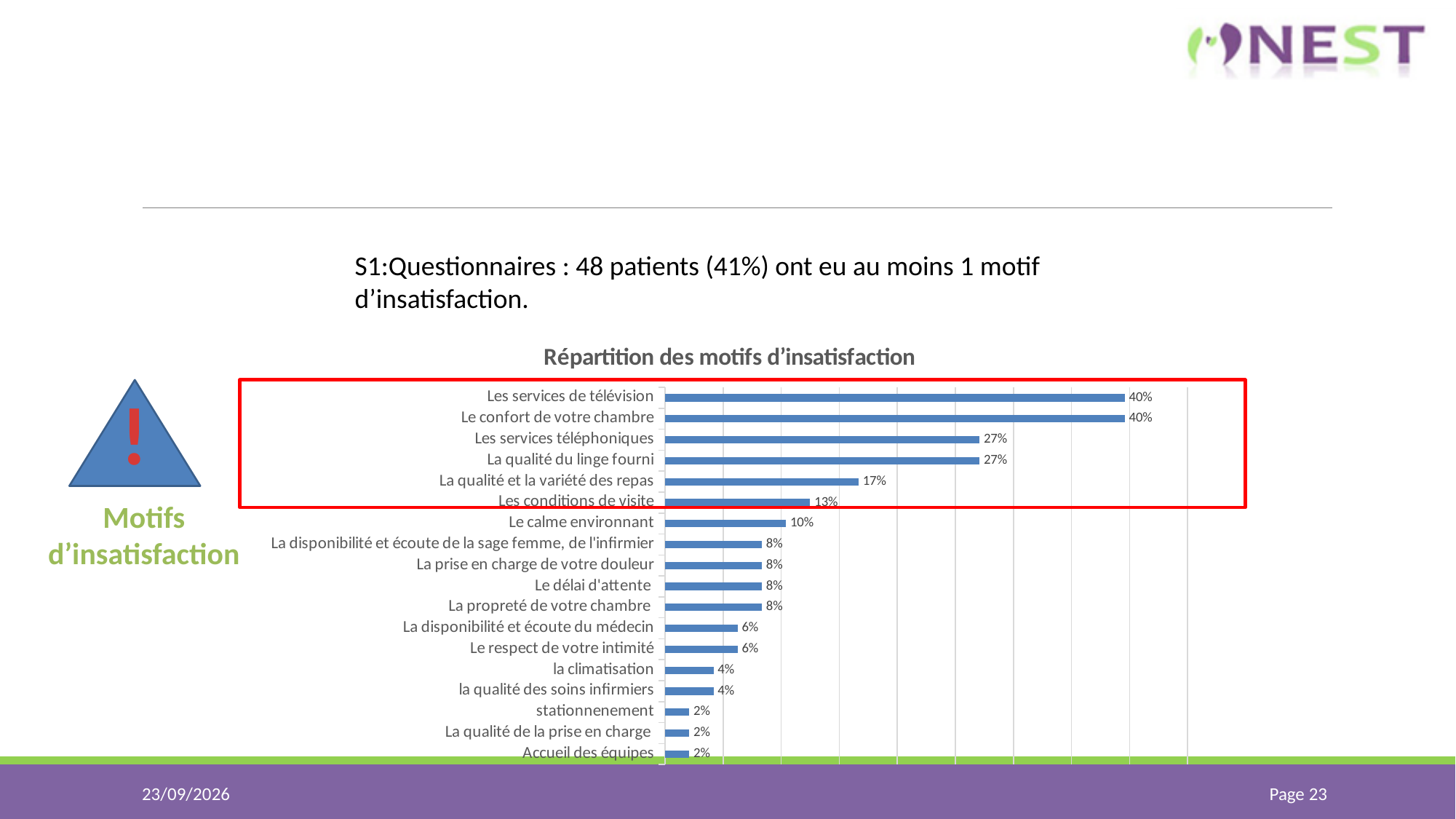
What type of chart is shown on the slide? bar chart What is the lowest value shown in the chart? 2% How many categories are shown in the chart? 18 What is the title of the chart? Répartition des motifs d'insatisfaction What is the value for 'Les services téléphoniques'? 27% Which is larger: the value for 'La qualité du linge fourni' or the value for 'Le délai d'attente'? La qualité du linge fourni What is the value for 'la climatisation'? 4% What is the difference between the value for 'Les services de télévision' and the value for 'Les conditions de visite'? 27% What is the highest value shown in the chart? 40% What is the value for 'La qualité et la variété des repas'? 17% What is the value for 'Le calme environnant'? 10% What is the value for 'Les conditions de visite'? 13%